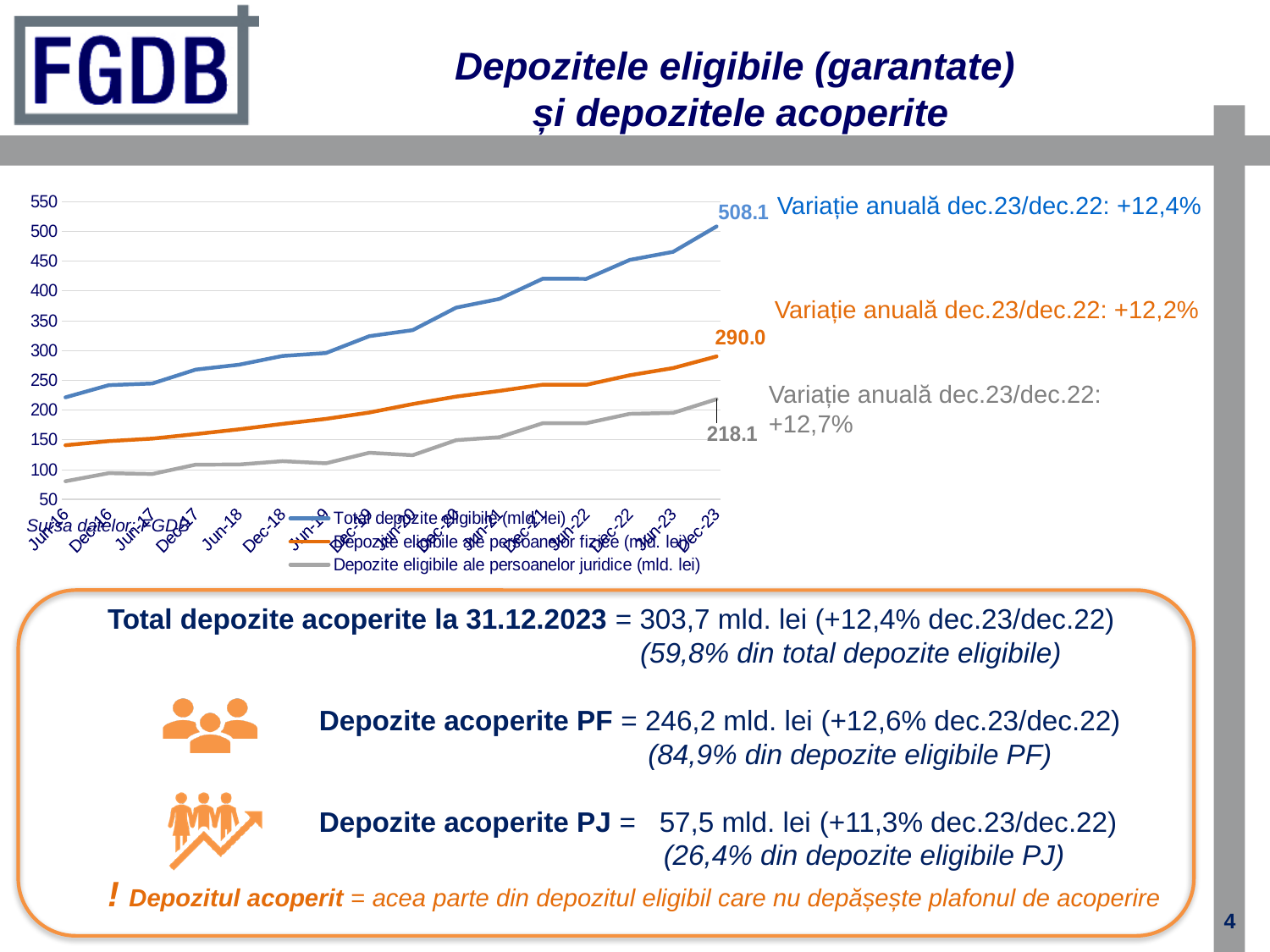
What is the value of Total depozite eligibile (mld. lei) at Dec-23? 508.1 Is the value for Depozite eligibile ale persoanelor juridice at Jun-16 greater or less than 100? less What is the difference between Total depozite eligibile and Depozite eligibile ale persoanelor fizice at Dec-23? 218.1 Which is larger at Dec-23: Depozite eligibile ale persoanelor fizice or Depozite eligibile ale persoanelor juridice? Depozite eligibile ale persoanelor fizice What is the value of Depozite eligibile ale persoanelor juridice (mld. lei) at Dec-23? 218.1 What is the value of Depozite eligibile ale persoanelor fizice (mld. lei) at Dec-23? 290.0 How many series does the chart legend list? 3 What kind of chart is shown on the slide? line chart Which series has the highest value at Dec-23? Total depozite eligibile (mld. lei) What is the difference between Depozite eligibile ale persoanelor fizice and Depozite eligibile ale persoanelor juridice at Dec-23? 71.9 Which series has the lowest value at Dec-23? Depozite eligibile ale persoanelor juridice (mld. lei) Do the values of Total depozite eligibile rise or fall from Jun-16 to Dec-23? rise